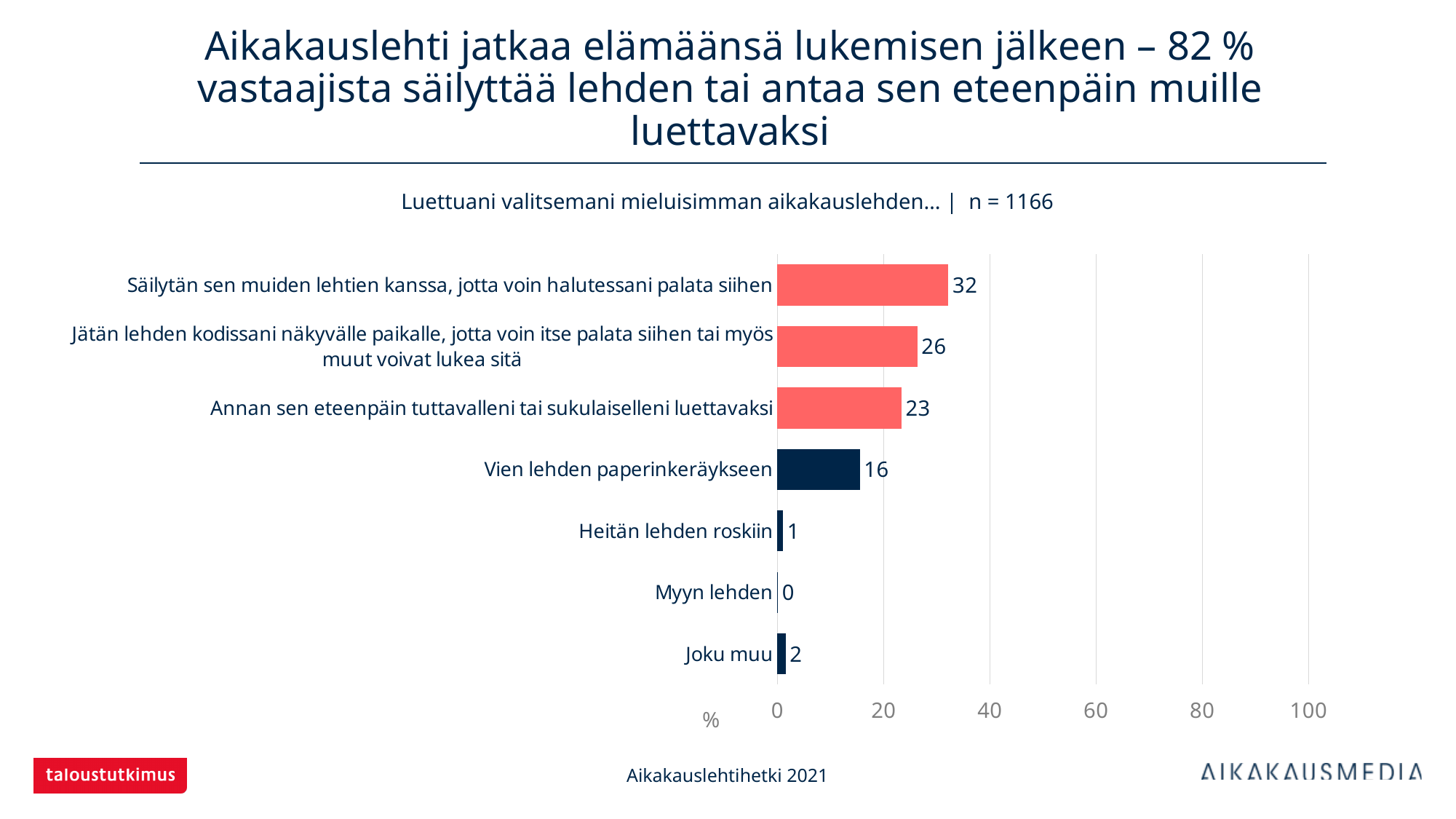
How many categories are shown in the chart? 7 Which is larger, the value for "Vien lehden paperinkeräykseen" or the value for "Joku muu"? Vien lehden paperinkeräykseen What is the sample size (n) stated above the chart? n = 1166 Is the value for "Jätän lehden kodissani näkyvälle paikalle, jotta voin itse palata siihen tai myös muut voivat lukea sitä" greater or less than 20? greater What kind of chart is shown on the slide? bar chart What is the value for "Vien lehden paperinkeräykseen"? 16 Which category has the lowest value? Myyn lehden What is the value for "Annan sen eteenpäin tuttavalleni tai sukulaiselleni luettavaksi"? 23 Which category has the highest value? Säilytän sen muiden lehtien kanssa, jotta voin halutessani palata siihen What is the highest tick value shown on the x axis? 100 What is the difference between the values for "Säilytän sen muiden lehtien kanssa, jotta voin halutessani palata siihen" and "Jätän lehden kodissani näkyvälle paikalle, jotta voin itse palata siihen tai myös muut voivat lukea sitä"? 6 What is the value for "Myyn lehden"? 0